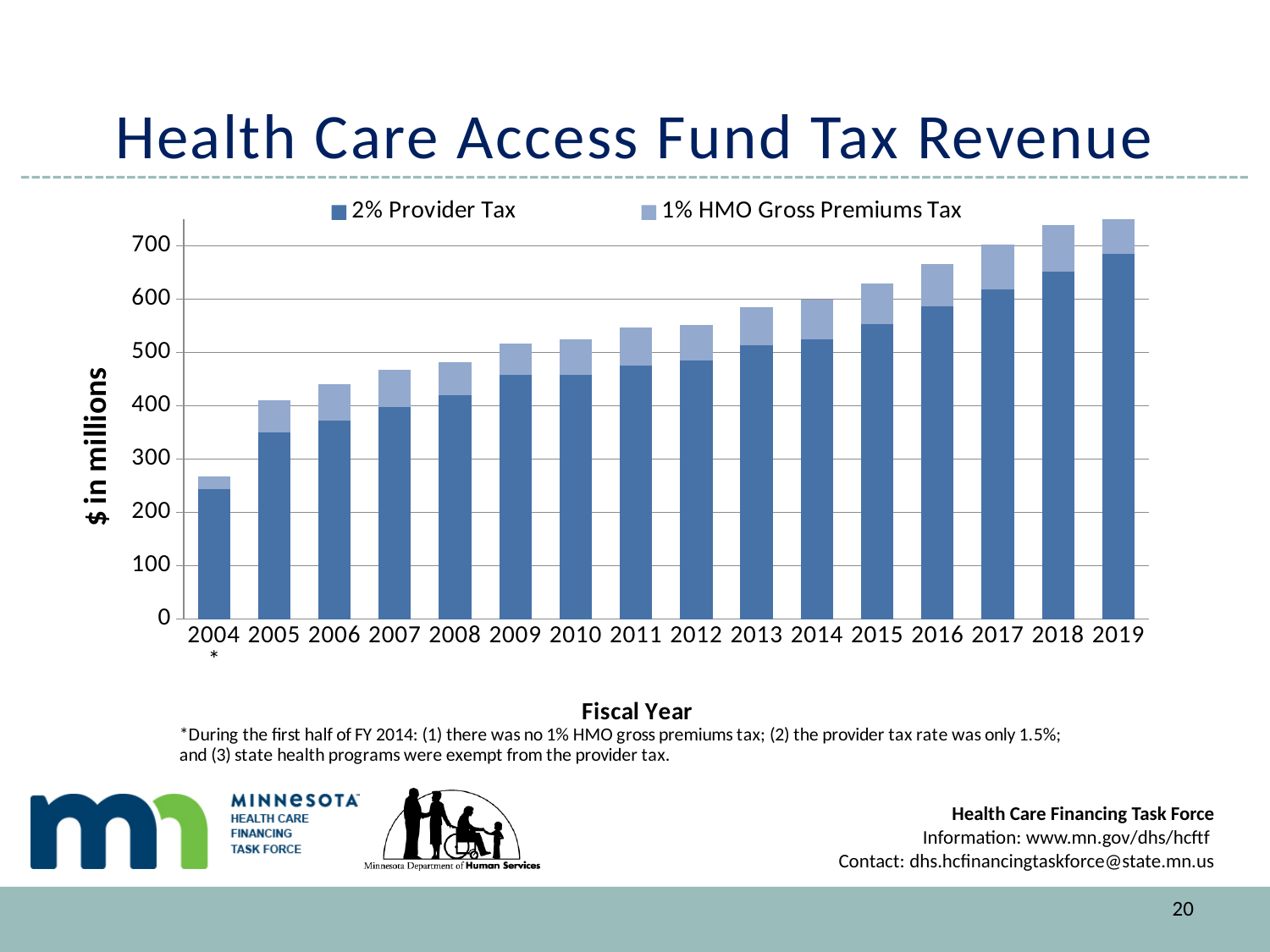
Is the total revenue for 2008 greater or less than 500? less How many fiscal years are shown on the x axis? 16 Which fiscal year has the highest total tax revenue? 2019 What kind of chart is shown on the slide? Stacked bar chart Is the total revenue for 2019 greater or less than 700? greater How many series does the legend list? 2 What is the label on the y axis? $ in millions Is the total revenue for 2004 greater or less than 300? less Which fiscal year has the lowest total tax revenue? 2004 Do total tax revenues generally rise or fall from 2004 to 2019? Rise